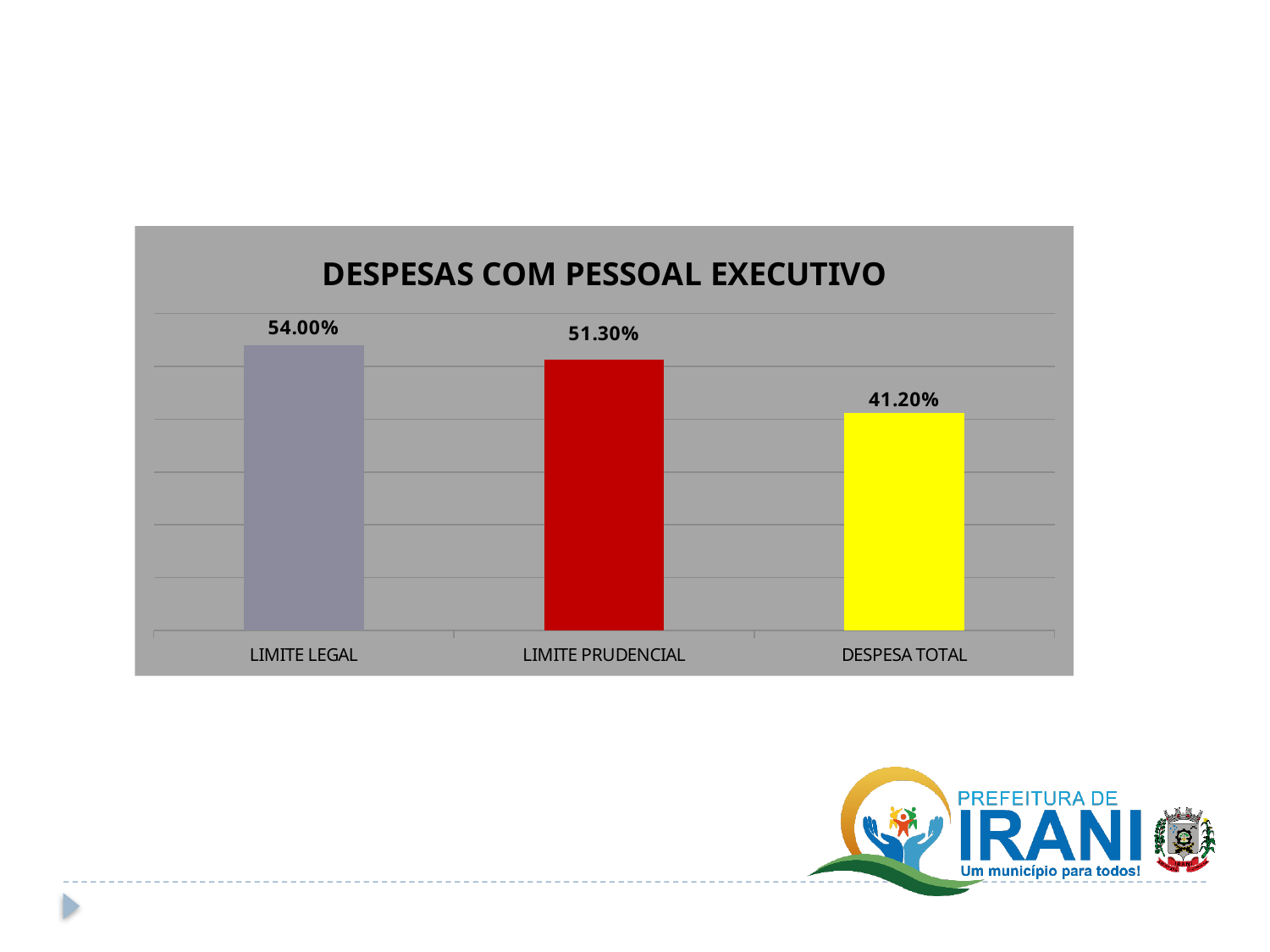
What kind of chart is shown? Bar chart What is the value for DESPESA TOTAL? 41.20% Which category has the lowest value? DESPESA TOTAL What is the value for LIMITE LEGAL? 54.00% What is the title of the chart? DESPESAS COM PESSOAL EXECUTIVO Do the values rise or fall from left to right along the x axis? Fall What is the difference between LIMITE LEGAL and DESPESA TOTAL? 12.80% Which is larger, LIMITE PRUDENCIAL or DESPESA TOTAL? LIMITE PRUDENCIAL Which category has the highest value? LIMITE LEGAL What is the difference between LIMITE PRUDENCIAL and DESPESA TOTAL? 10.10% What is the value for LIMITE PRUDENCIAL? 51.30% How many categories are shown in the chart? 3